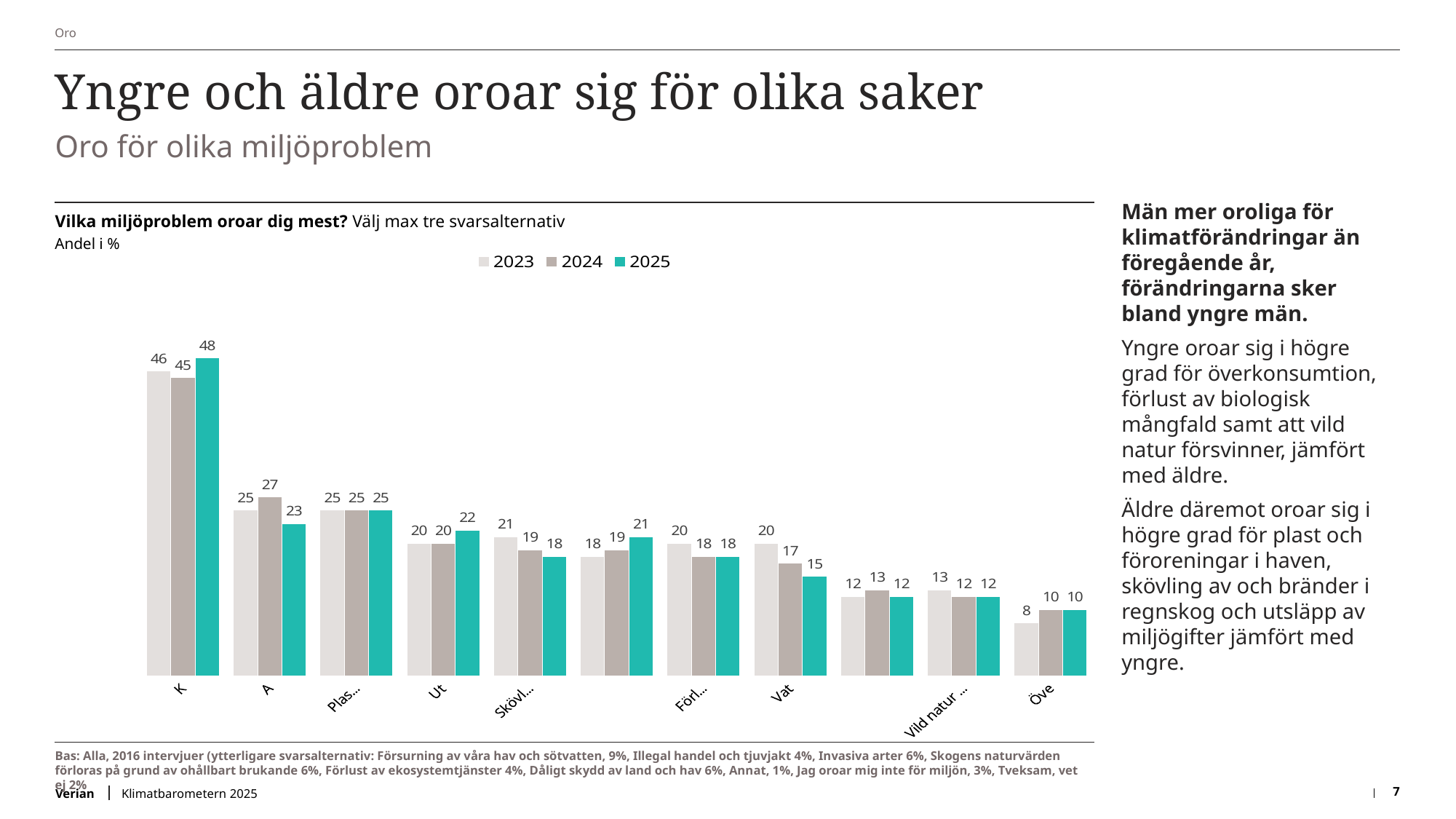
In the leftmost group of bars, what is the difference between the 2025 value and the 2024 value? 3 What kind of chart is shown on the slide? bar chart What is the 2023 value for the rightmost group of bars? 8 What is the highest value shown for the 2025 series? 48 What is the 2024 value for the rightmost group of bars? 10 How many series does the legend list? 3 Which years are listed in the chart legend? 2023, 2024, 2025 In the second group of bars from the left, which year has the larger value, 2024 or 2025? 2024 What is the 2025 value for the leftmost group of bars? 48 What is the 2023 value for the leftmost group of bars? 46 What is the lowest value shown for the 2023 series? 8 How many groups of bars (categories) are plotted in the chart? 11